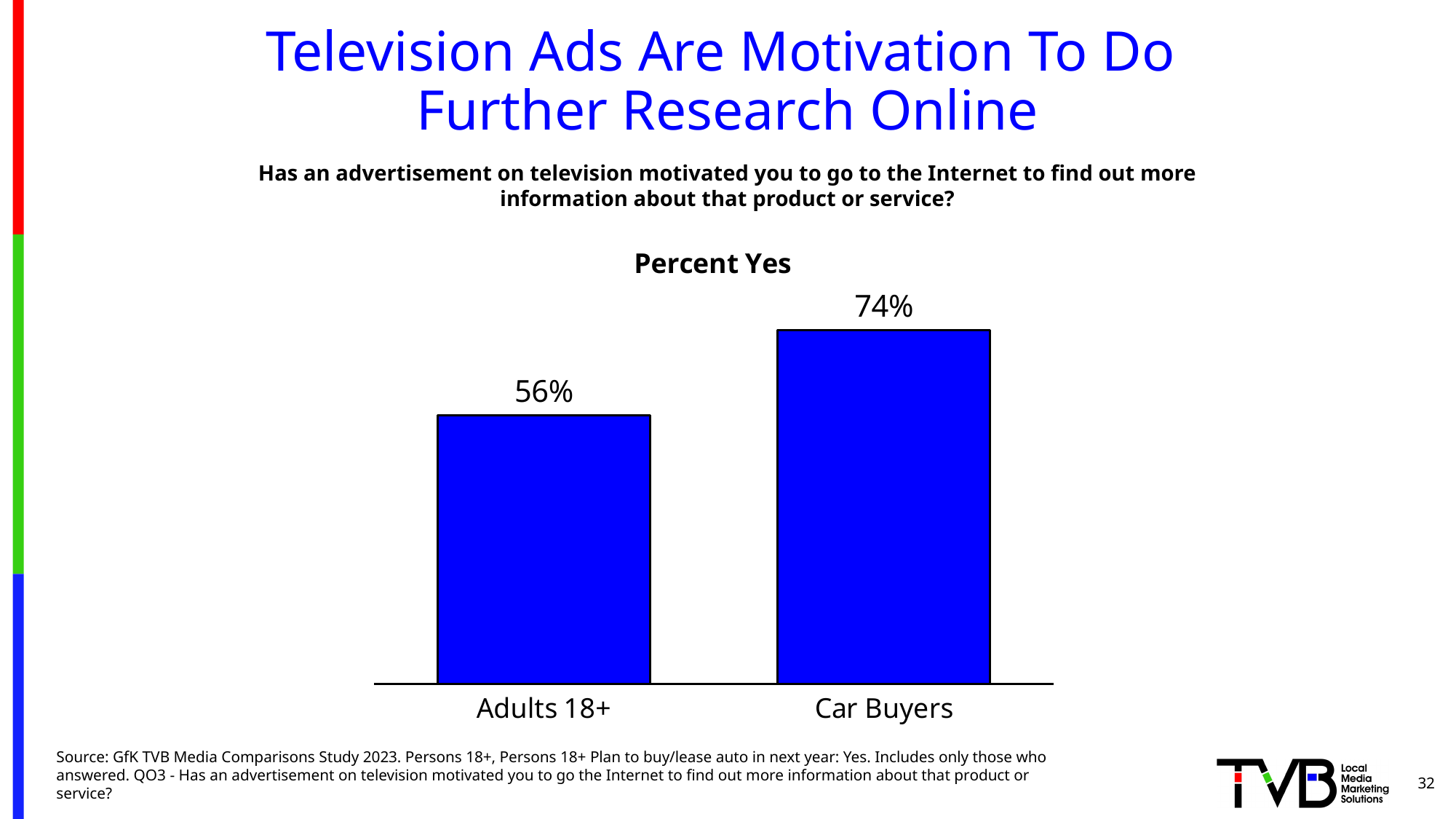
What is the Percent Yes value for Car Buyers? 74% What kind of chart is shown on the slide? Bar chart Which category has the lowest Percent Yes value? Adults 18+ What is the difference in Percent Yes between Car Buyers and Adults 18+? 18% Do the values rise or fall from Adults 18+ to Car Buyers? Rise What is the Percent Yes value for Adults 18+? 56% What is the title of the chart? Percent Yes Which category has the highest Percent Yes value? Car Buyers Which is larger, the Percent Yes for Adults 18+ or for Car Buyers? Car Buyers How many categories are shown in the chart? 2 What colour are the bars in the chart? Blue